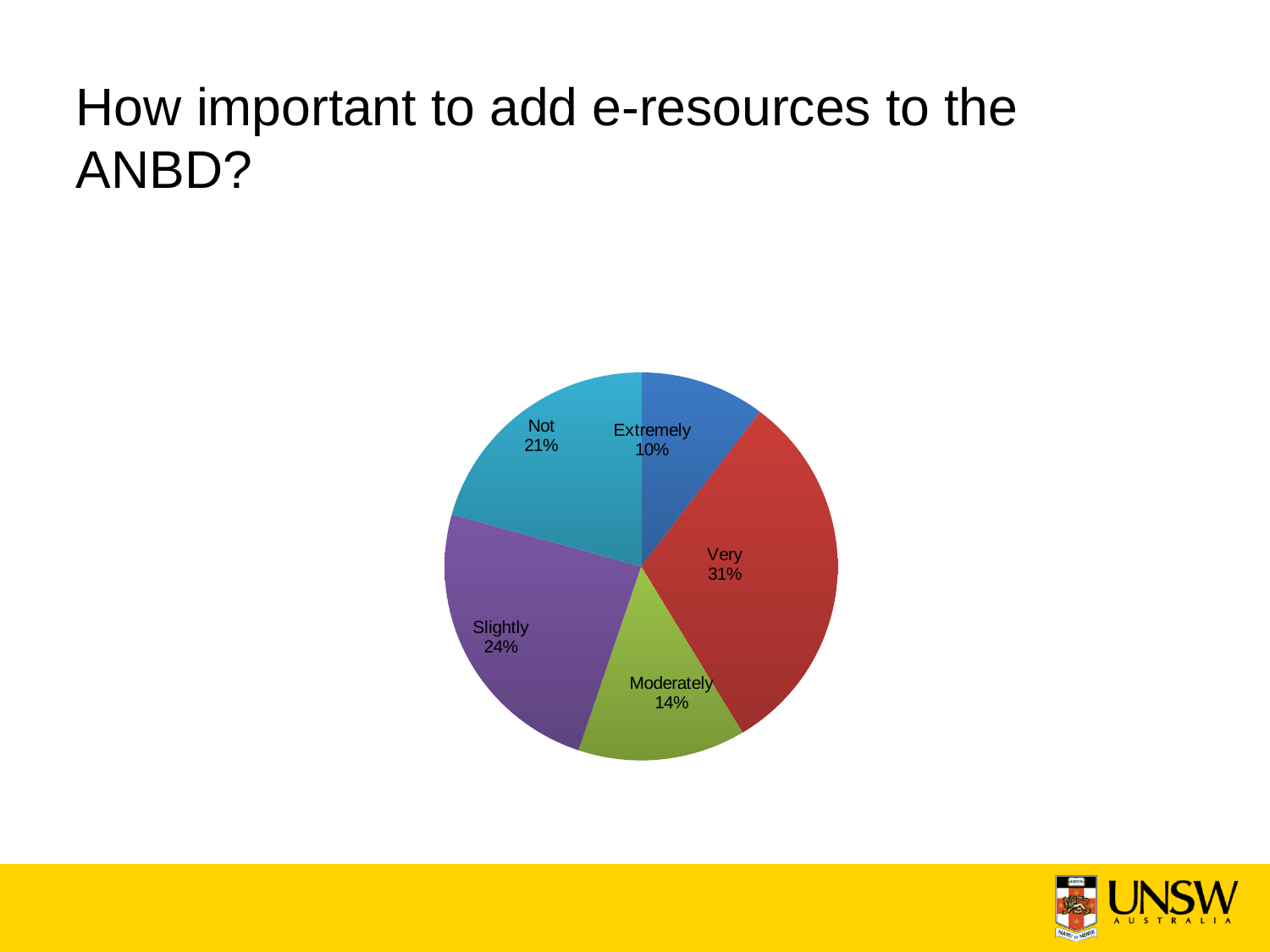
Which is larger, the 'Slightly' slice or the 'Not' slice? Slightly What is the value for the 'Extremely' slice? 10% What percentage of respondents said it is 'Very' important to add e-resources to the ANBD? 31% Which category has the smallest slice of the pie? Extremely What percentage is shown for 'Moderately'? 14% What is the difference in percentage points between the 'Very' and 'Extremely' slices? 21 Which category has the largest slice of the pie? Very How many slices does the pie chart have? 5 What share of the pie is labelled 'Not'? 21% What is the title of the slide containing the pie chart? How important to add e-resources to the ANBD? What is the value for the 'Slightly' slice? 24% What kind of chart is shown on the slide? pie chart